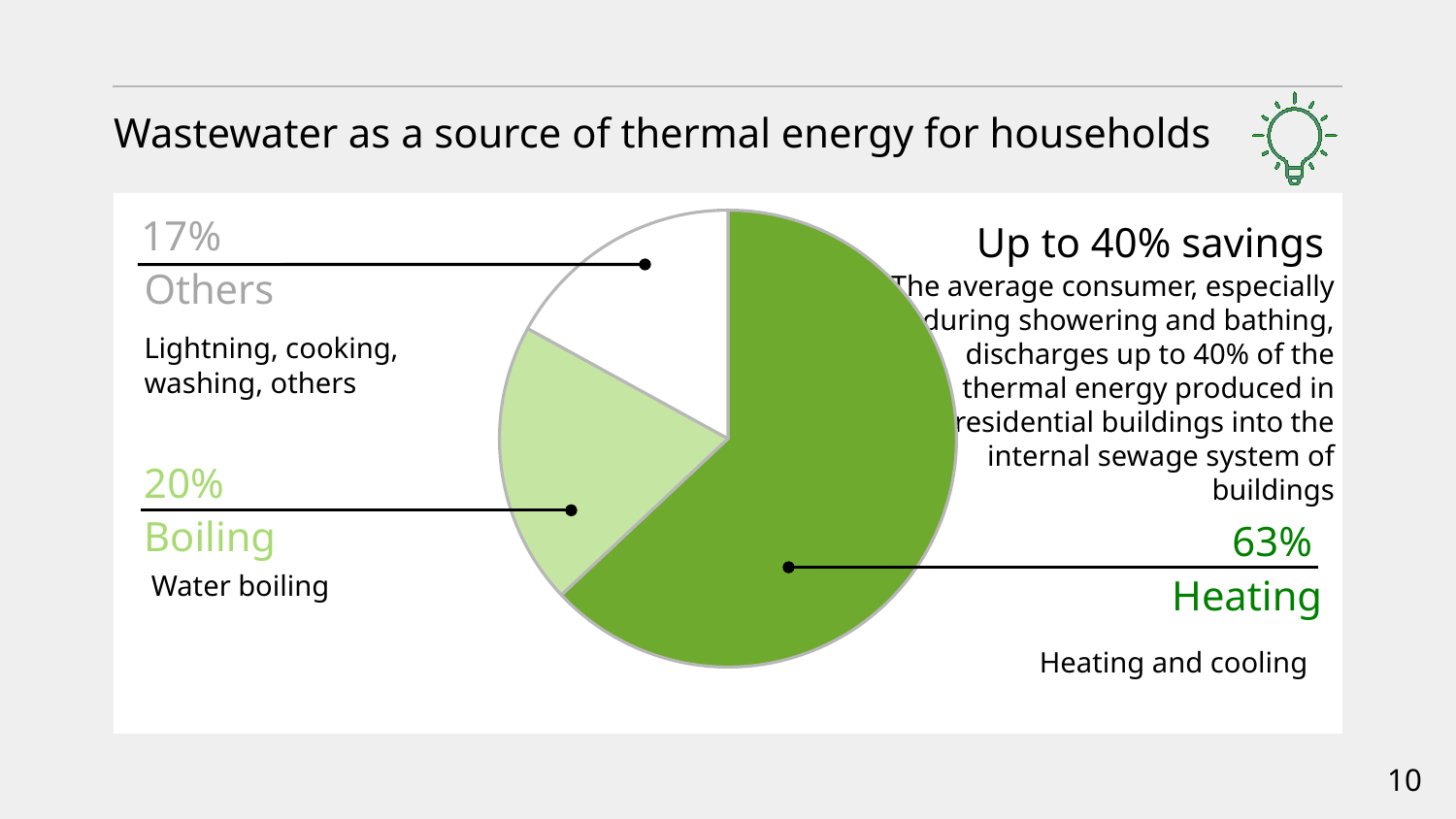
Which is larger, the Boiling slice or the Others slice? Boiling Which slice of the pie chart is the largest? Heating What kind of chart is shown on the slide? pie chart Which slice of the pie chart is the smallest? Others How many slices does the pie chart have? 3 What share of the pie does Heating account for? 63% What share of the pie does Others account for? 17% What share of the pie does Boiling account for? 20% What is the title of the slide containing the pie chart? Wastewater as a source of thermal energy for households What is the difference in percentage points between Boiling and Others? 3 What is the combined share of Boiling and Others? 37% What is the difference in percentage points between Heating and Boiling? 43